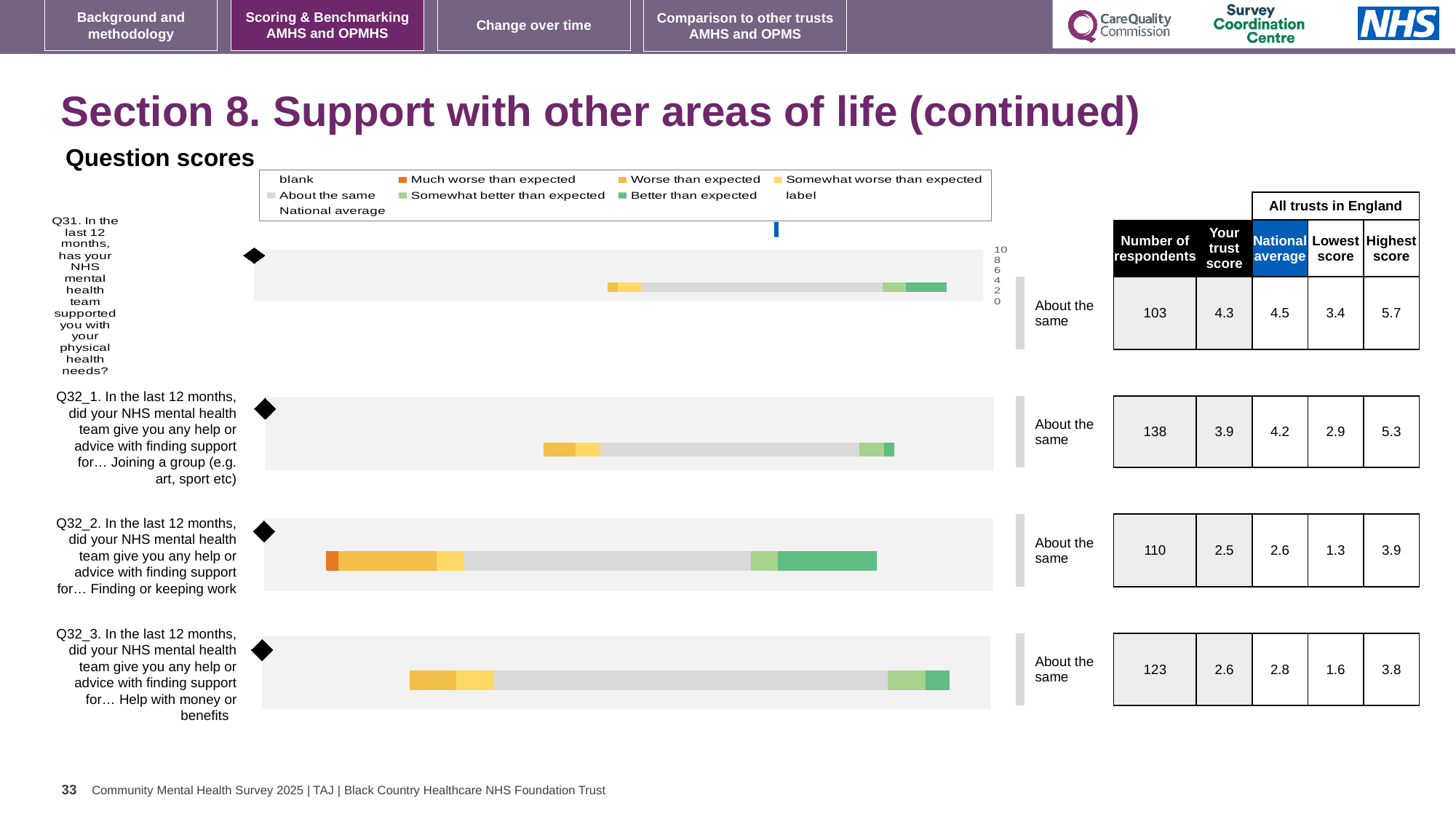
What is the number of respondents for Q31 (support with physical health needs)? 103 What is the trust score for Q32_1 (help with joining a group)? 3.9 What is the national average for Q32_2 (help with finding or keeping work)? 2.6 For Q31, which is larger: the trust score or the national average? national average What benchmark category is shown for Q32_3 (help with money or benefits)? About the same Which question has the lowest trust score? Q32_2 (finding or keeping work) What kind of chart is used to show the question scores on this slide? bar chart How many questions (bars) are plotted on the slide? 4 What is the highest score among all trusts in England for Q32_3 (help with money or benefits)? 3.8 What is the lowest score among all trusts in England for Q32_2 (finding or keeping work)? 1.3 Which question has the highest number of respondents? Q32_1 (joining a group) What is the difference between the highest score and the lowest score for Q31? 2.3